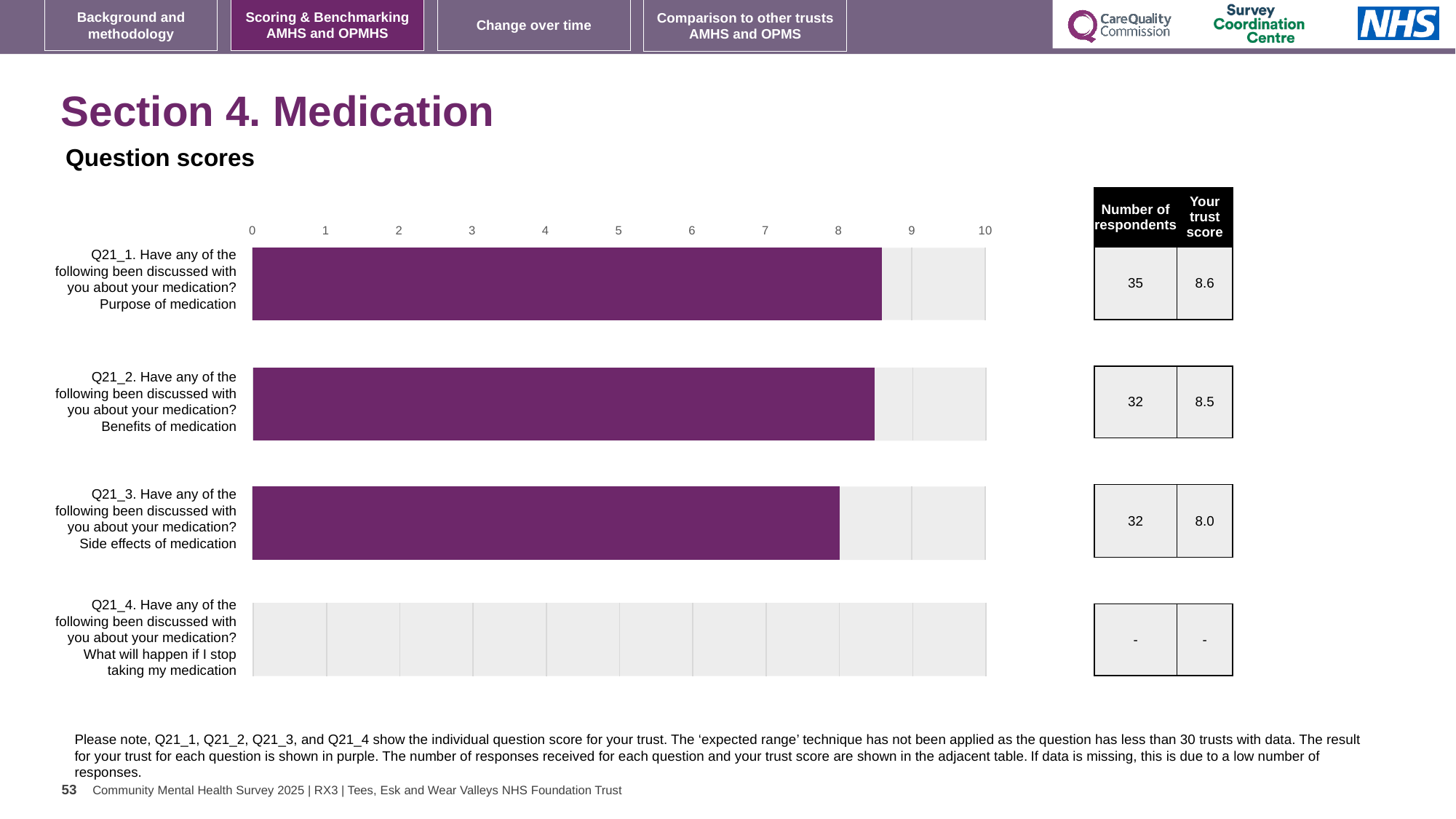
Which question has the lowest trust score among those with data shown? Q21_3. Side effects of medication What is the trust score for Q21_1 (Purpose of medication)? 8.6 What kind of chart is shown on the slide? bar chart Is the value for Q21_3 (Side effects of medication) greater or less than 7? greater What colour are the bars showing the trust's results? purple Which has a larger trust score, Q21_2 (Benefits of medication) or Q21_3 (Side effects of medication)? Q21_2. Benefits of medication What is the difference between the trust scores for Q21_1 (Purpose of medication) and Q21_3 (Side effects of medication)? 0.6 What is the trust score for Q21_3 (Side effects of medication)? 8.0 Which question has the highest trust score? Q21_1. Purpose of medication How many questions (categories) are listed on the chart? 4 How many respondents answered Q21_1 (Purpose of medication)? 35 What is the trust score for Q21_2 (Benefits of medication)? 8.5